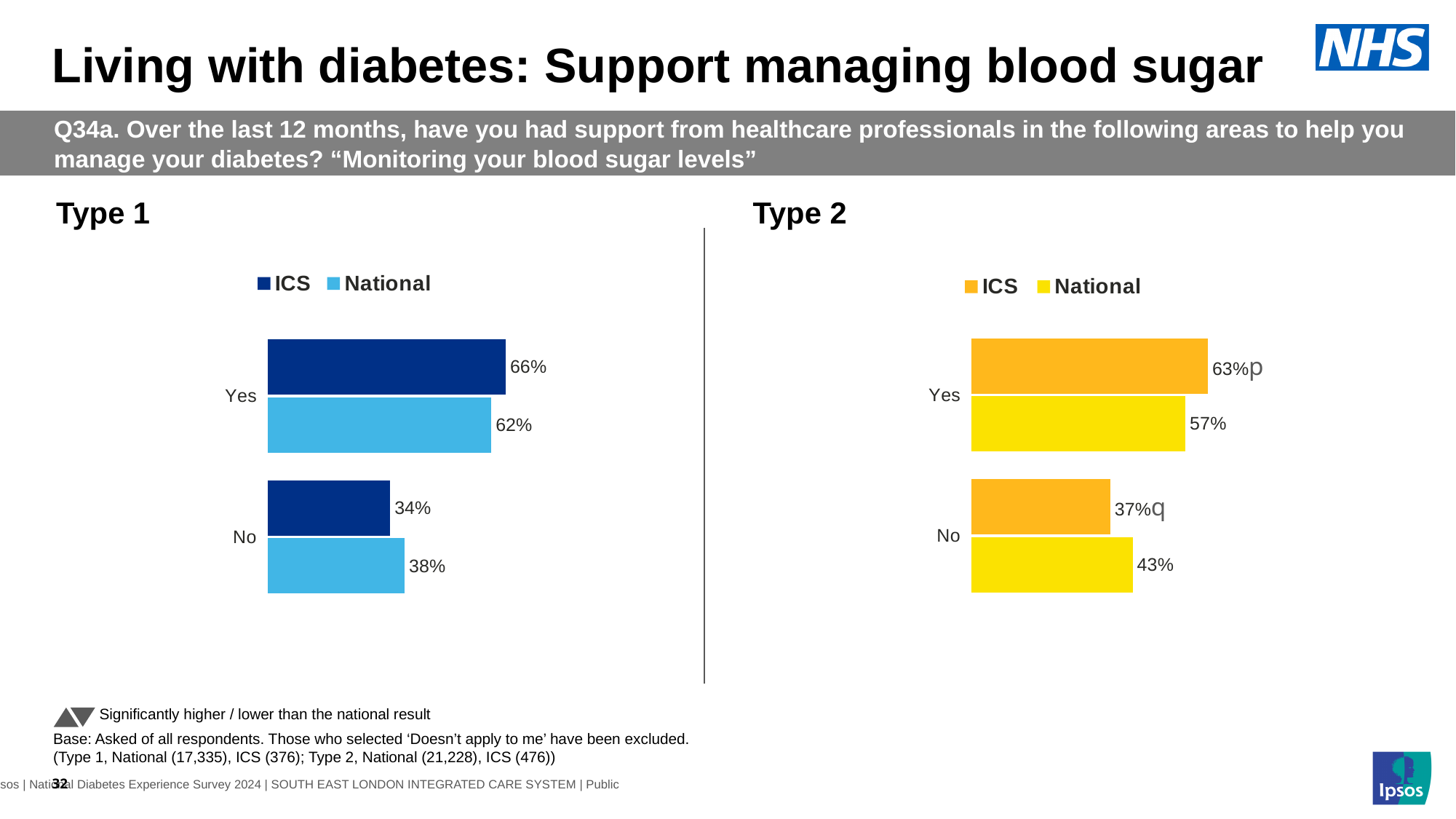
In the Type 2 chart, what is the National value for Yes? 57% In the Type 2 chart, what is the ICS value for Yes? 63% In the Type 2 chart, which is larger for Yes: ICS or National? ICS In the Type 1 chart, what is the National value for No? 38% How many categories are shown in the Type 1 chart? 2 In the Type 1 chart, what is the ICS value for Yes? 66% In the Type 1 chart, what is the difference between the ICS and National values for Yes? 4 percentage points How many series does the legend of the Type 2 chart list? 2 What kind of chart is the Type 1 chart? Bar chart In the Type 2 chart, what is the difference between the National and ICS values for No? 6 percentage points In the Type 1 chart, which is larger for No: ICS or National? National In the Type 2 chart, what is the ICS value for No? 37%